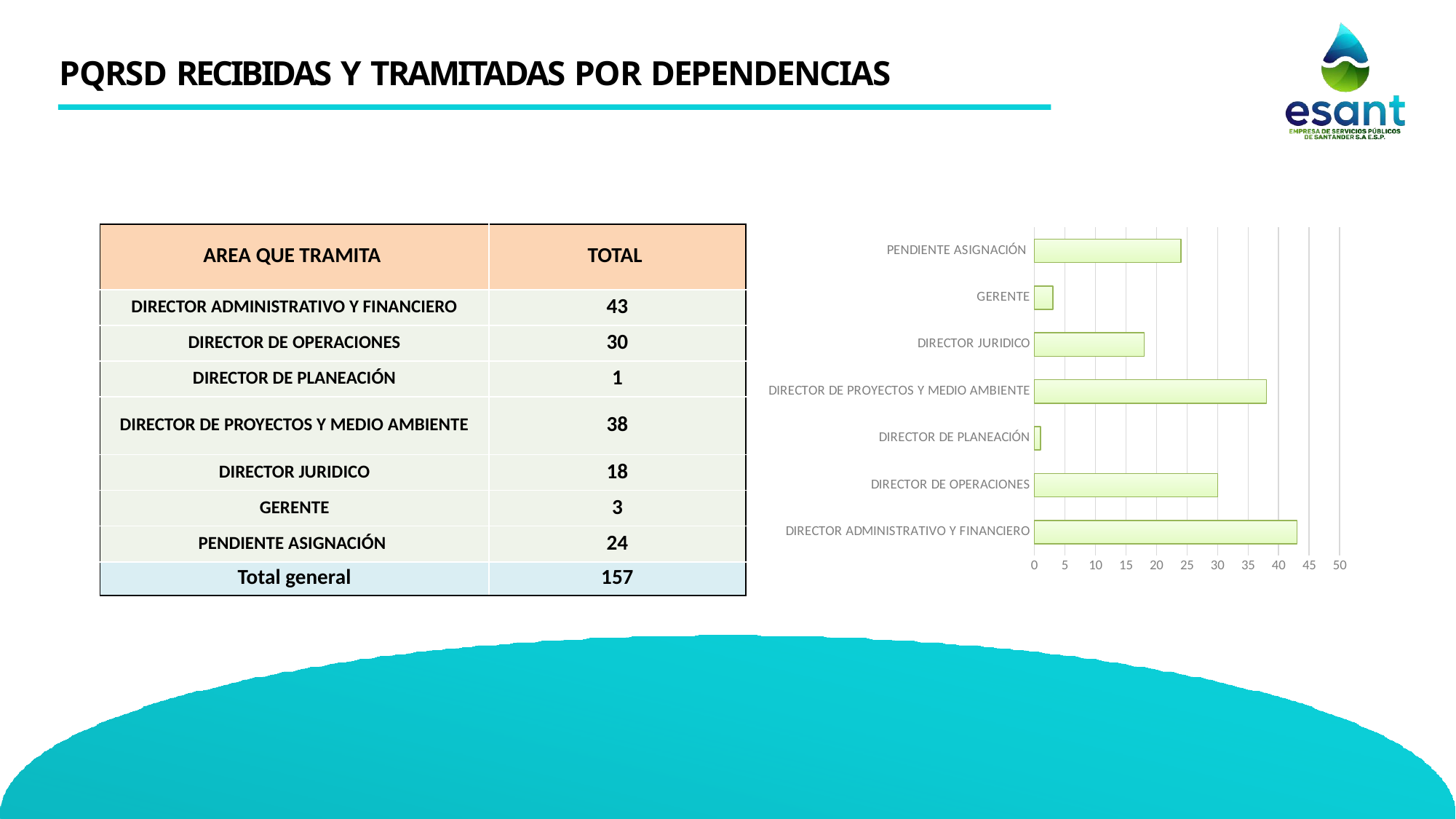
What kind of chart is shown on the slide? bar chart Is the value for DIRECTOR ADMINISTRATIVO Y FINANCIERO greater or less than 40? greater How many categories does the bar chart show? 7 What is the value for DIRECTOR DE OPERACIONES? 30 What is the value for PENDIENTE ASIGNACIÓN? 24 What is the highest value shown on the chart's horizontal axis? 50 Which is larger, the value for GERENTE or the value for DIRECTOR JURIDICO? DIRECTOR JURIDICO Which category has the longest bar in the chart? DIRECTOR ADMINISTRATIVO Y FINANCIERO What is the difference between the values for DIRECTOR ADMINISTRATIVO Y FINANCIERO and DIRECTOR DE OPERACIONES? 13 What is the value for DIRECTOR DE PROYECTOS Y MEDIO AMBIENTE? 38 Which category has the shortest bar in the chart? DIRECTOR DE PLANEACIÓN Is the value for DIRECTOR JURIDICO greater or less than 20? less